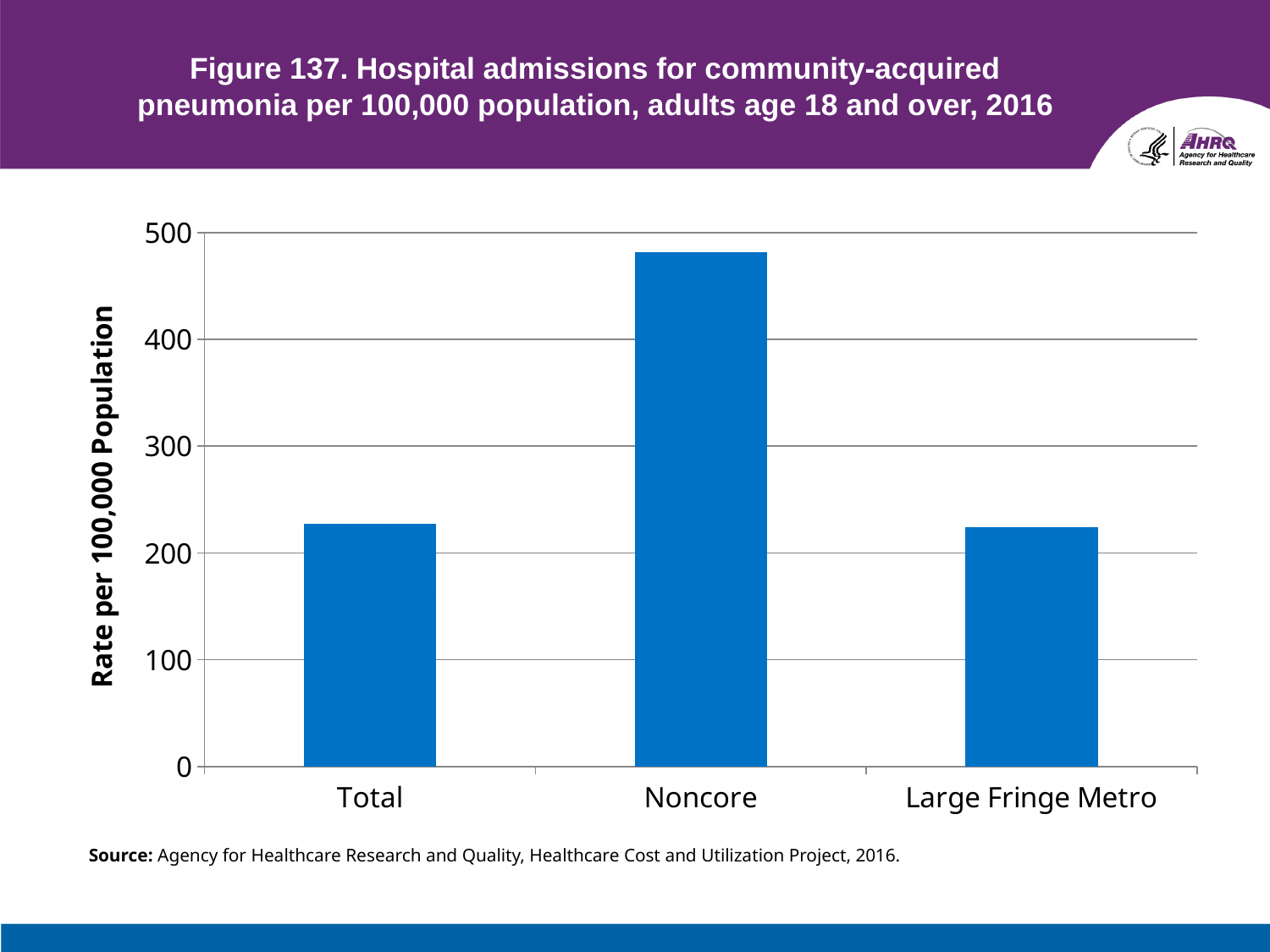
What kind of chart is shown on the slide? bar chart Which is larger, the value for Noncore or the value for Large Fringe Metro? Noncore Is the value for Noncore greater or less than 400? greater Which category has the highest hospital admission rate? Noncore Is the value for Total greater or less than 200? greater Is the value for Large Fringe Metro greater or less than 300? less How many categories are shown on the x axis of the chart? 3 What is the label on the y axis of the chart? Rate per 100,000 Population What year of data does the chart title say it shows? 2016